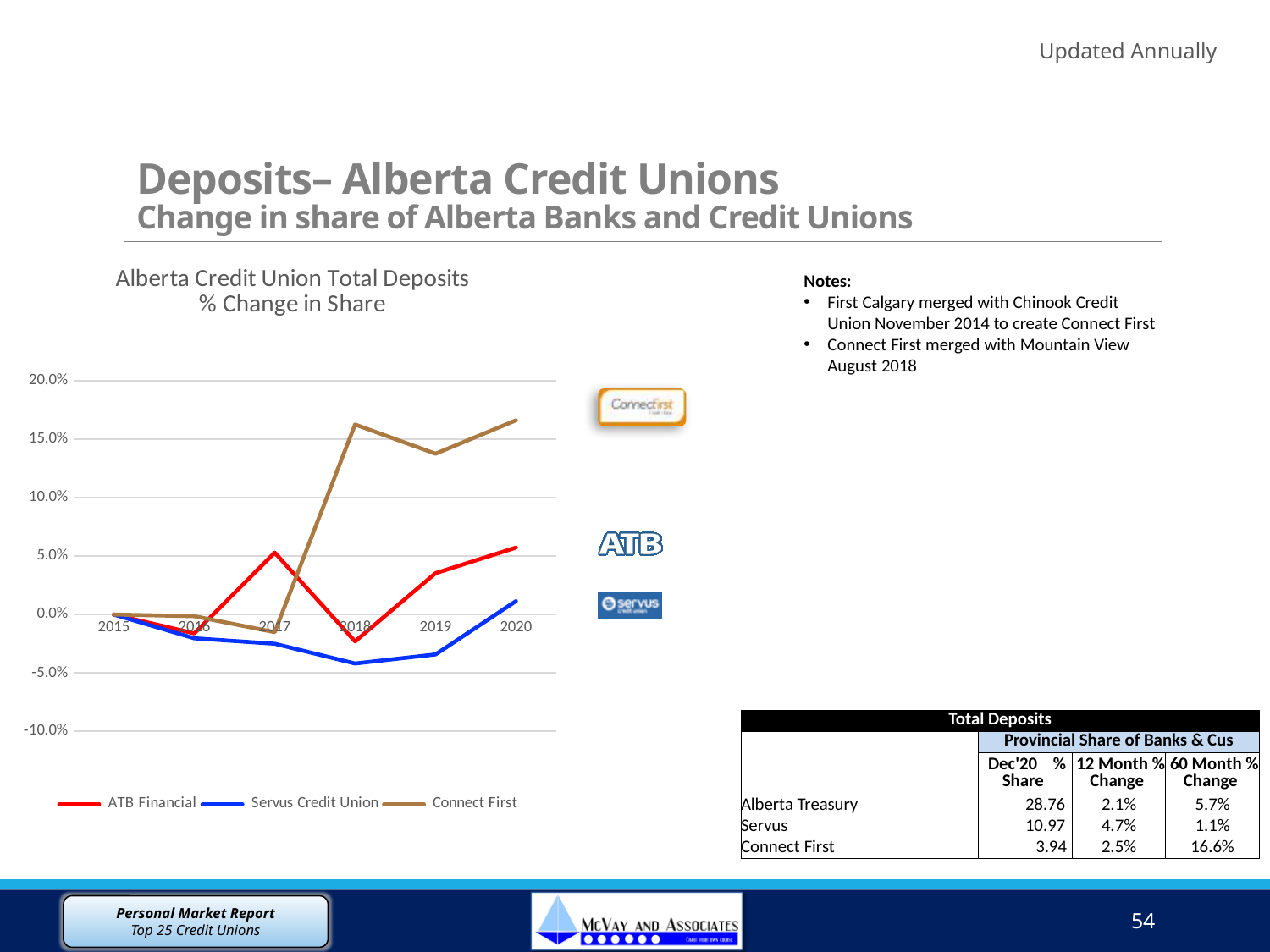
What kind of chart is shown on the slide? line chart Is the value for Servus Credit Union in 2018 greater or less than 0.0%? less Does the Servus Credit Union line rise or fall from 2015 to 2018? fall In 2018, which is larger: the value for ATB Financial or the value for Servus Credit Union? ATB Financial How many series does the chart legend list? 3 Which series has the lowest value in 2018? Servus Credit Union Is the value for Connect First in 2019 greater or less than 10.0%? greater Is the value for ATB Financial in 2017 greater or less than 0.0%? greater Which series has the highest value in 2020? Connect First What is the title of the chart? Alberta Credit Union Total Deposits % Change in Share How many years are plotted along the x axis of the chart? 6